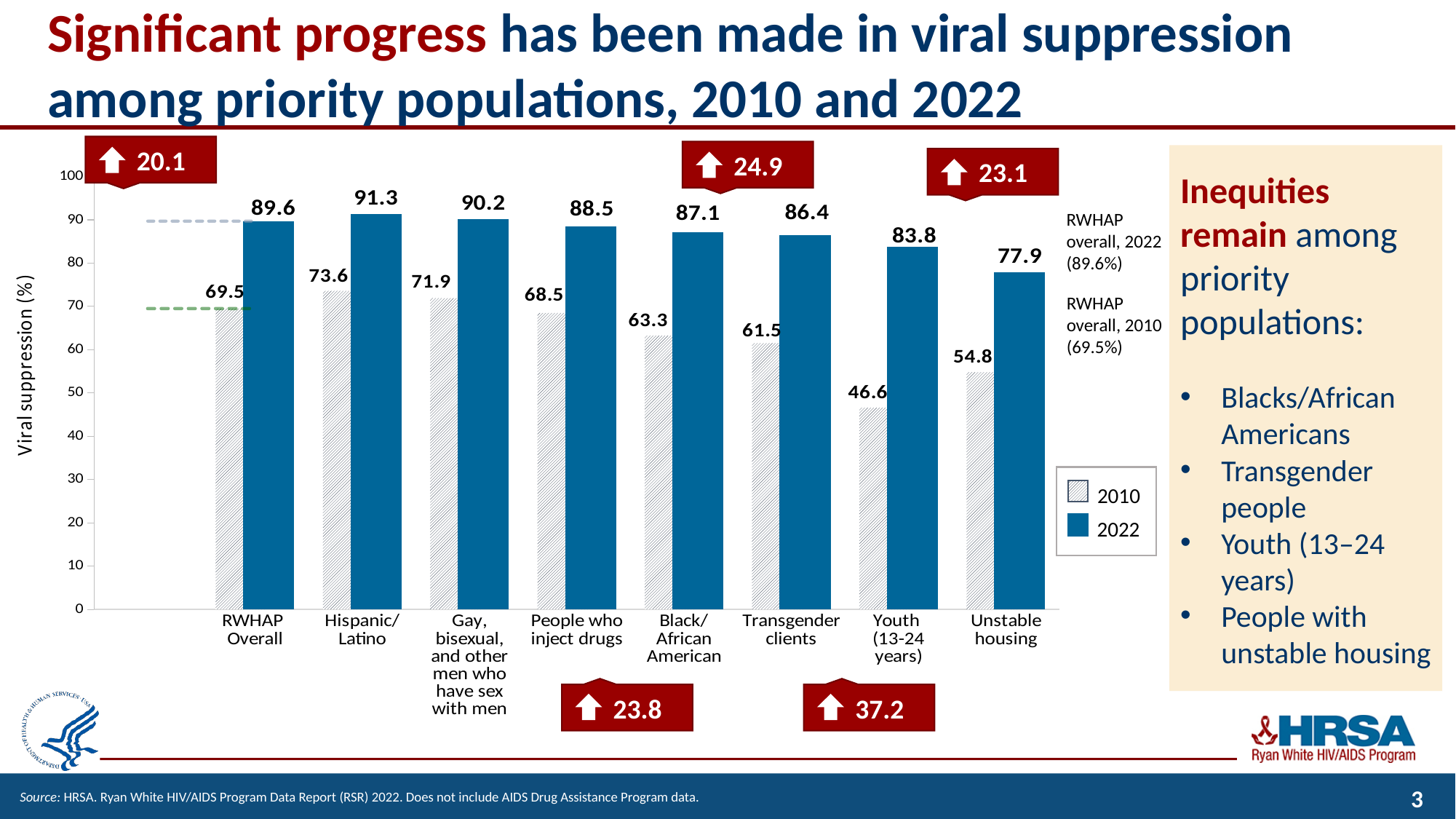
What was the viral suppression value for Transgender clients in 2022? 86.4 Which category has the highest 2022 viral suppression value? Hispanic/Latino What was the viral suppression value for Black/African American in 2010? 63.3 What kind of chart is shown on the slide? Bar chart How many population categories are shown on the x axis? 8 What was the viral suppression value for Youth (13-24 years) in 2010? 46.6 Which category has the lowest 2010 viral suppression value? Youth (13-24 years) What is the difference between the 2022 and 2010 values for RWHAP Overall? 20.1 What is the difference between the 2022 and 2010 values for People with unstable housing? 23.1 Which is larger, the 2022 value for People who inject drugs or the 2022 value for Black/African American? People who inject drugs How many series does the legend list? 2 What is the label of the y axis? Viral suppression (%)